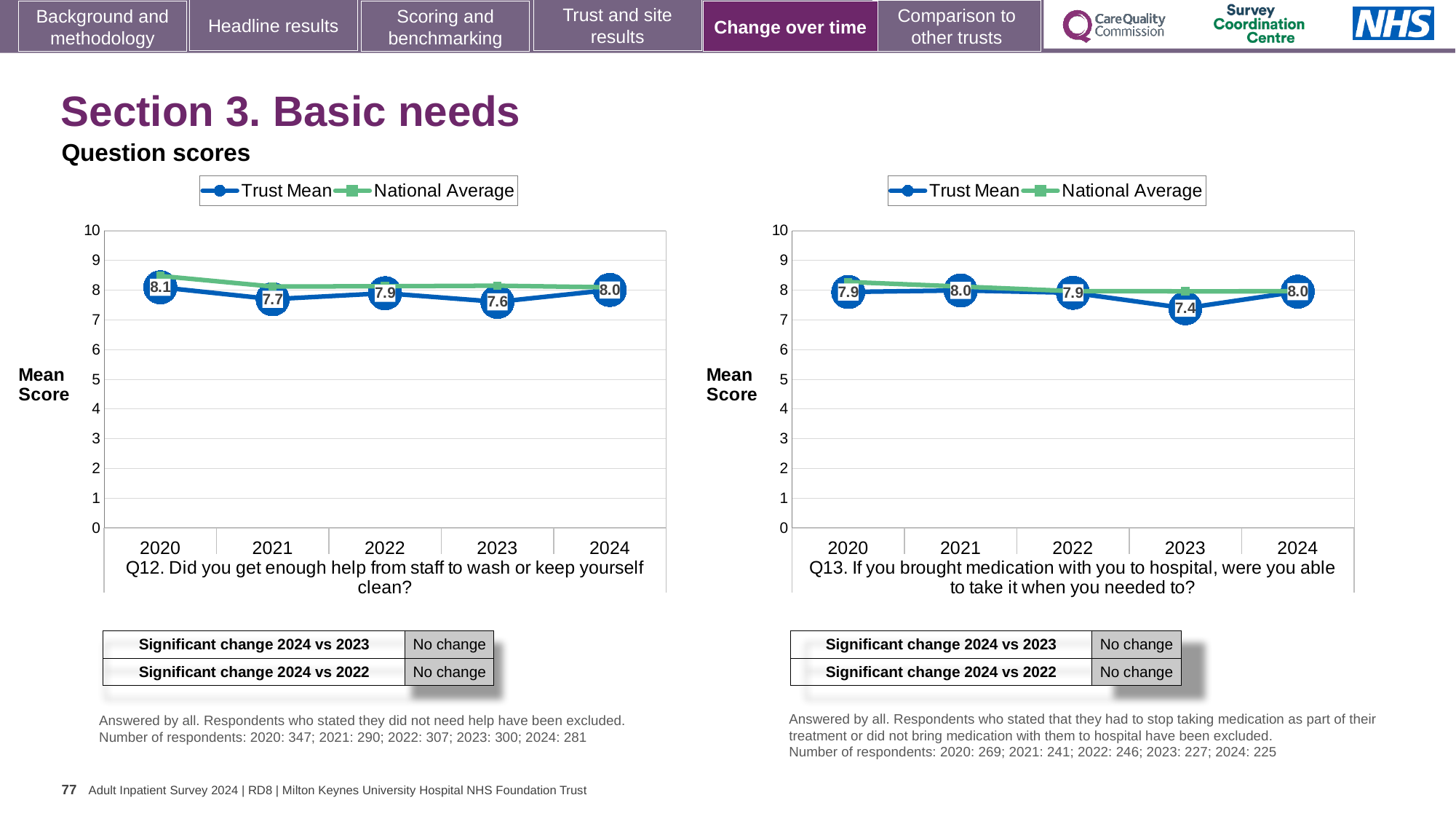
In the Q12 chart (left), what is the Trust Mean for 2023? 7.6 How many years are plotted on the x axis of the Q12 chart (left)? 5 In the Q12 chart (left), which year has the highest Trust Mean? 2020 In the Q13 chart (right), which year has the lowest Trust Mean? 2023 In the Q12 chart (left), what is the difference between the Trust Mean for 2020 and 2023? 0.5 In the Q12 chart (left), what is the Trust Mean for 2020? 8.1 In the Q13 chart (right), is the Trust Mean for 2021 larger or smaller than the Trust Mean for 2023? larger In the Q13 chart (right), what is the Trust Mean for 2024? 8.0 In the Q12 chart (left), which year has the lowest Trust Mean? 2023 In the Q13 chart (right), what is the Trust Mean for 2023? 7.4 How many series does the legend of the Q13 chart (right) list? 2 What kind of chart is the Q12 chart (left)? Line chart